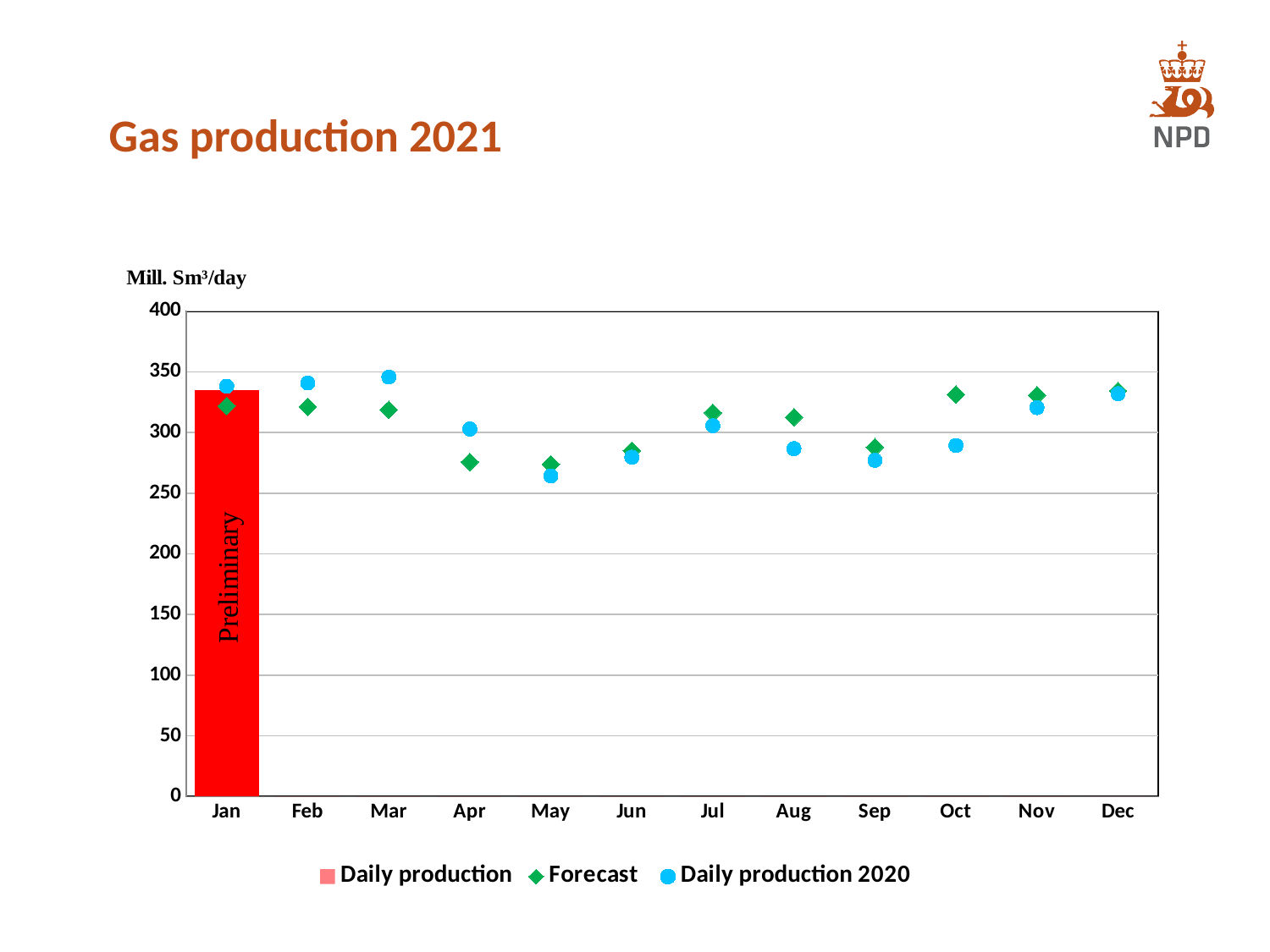
How many series does the chart legend list? 3 Is the Forecast value for May greater or less than 300? less In Apr, which is larger: the Forecast value or the Daily production 2020 value? Daily production 2020 In which month is the Daily production 2020 value lowest? May What unit is shown on the y axis of the chart? Mill. Sm³/day Is the Daily production value for Jan greater or less than 300? greater Is the Daily production 2020 value for Mar greater or less than 300? greater How many months are shown on the x axis of the chart? 12 In Oct, which is larger: the Forecast value or the Daily production 2020 value? Forecast What is the title of the chart on the slide? Gas production 2021 Do the Forecast values rise or fall from Jan to May? fall